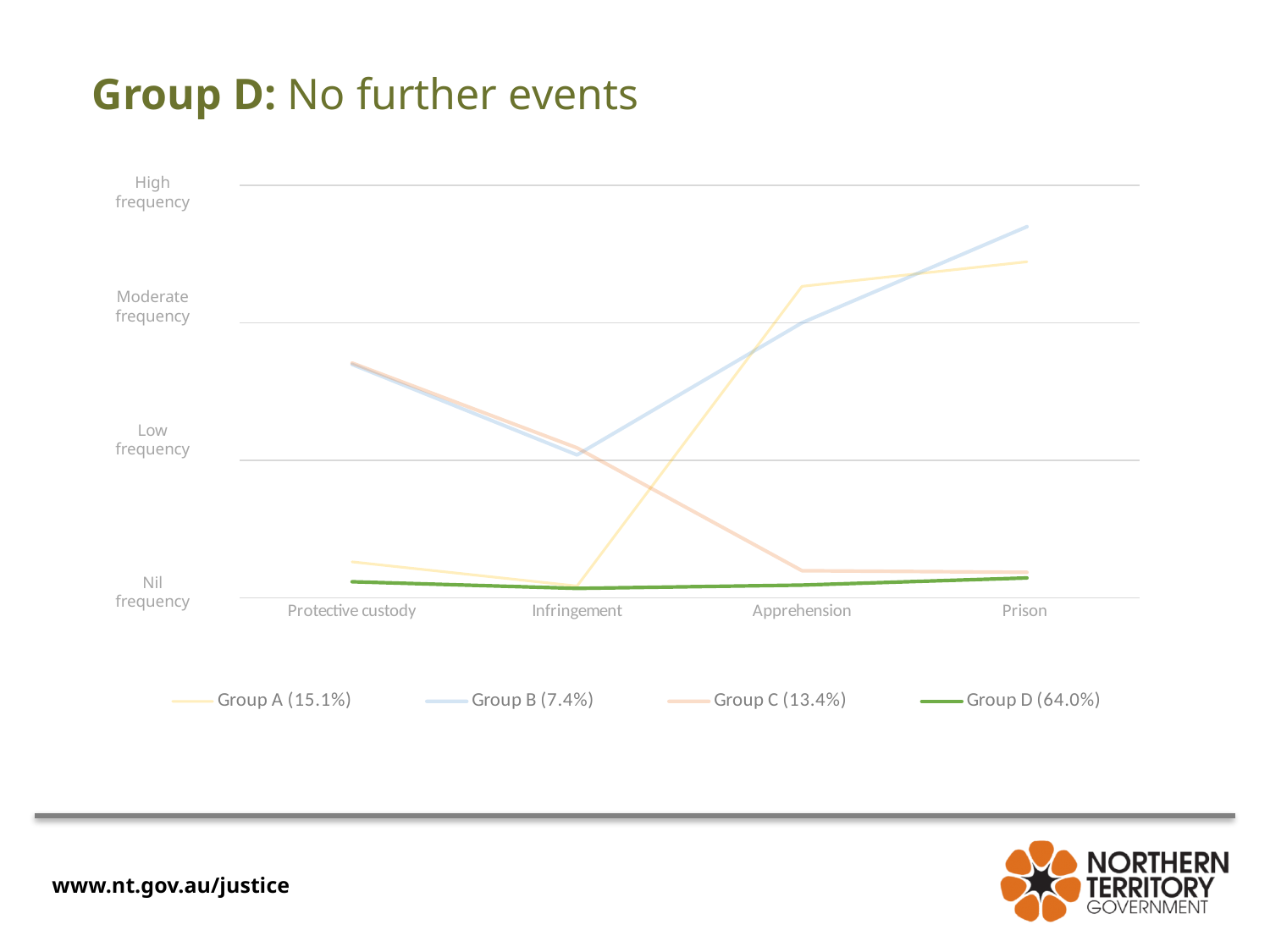
At Prison, which series is higher: Group A or Group B? Group B How many series does the chart's legend list? 4 Does the Group B line rise or fall from Infringement to Prison? Rises What kind of chart is shown on the slide? Line chart How many categories are shown on the x axis of the chart? 4 Is the value for Group B at Prison greater or less than the Moderate frequency level? greater What percentage is shown next to Group D in the legend? 64.0% Does the Group C line rise or fall from Protective custody to Apprehension? Falls Which series has the highest value at Prison? Group B (7.4%) Is the value for Group A at Infringement greater or less than the Low frequency level? less What is the title of the slide containing the chart? Group D: No further events At Apprehension, which series is higher: Group A or Group B? Group A